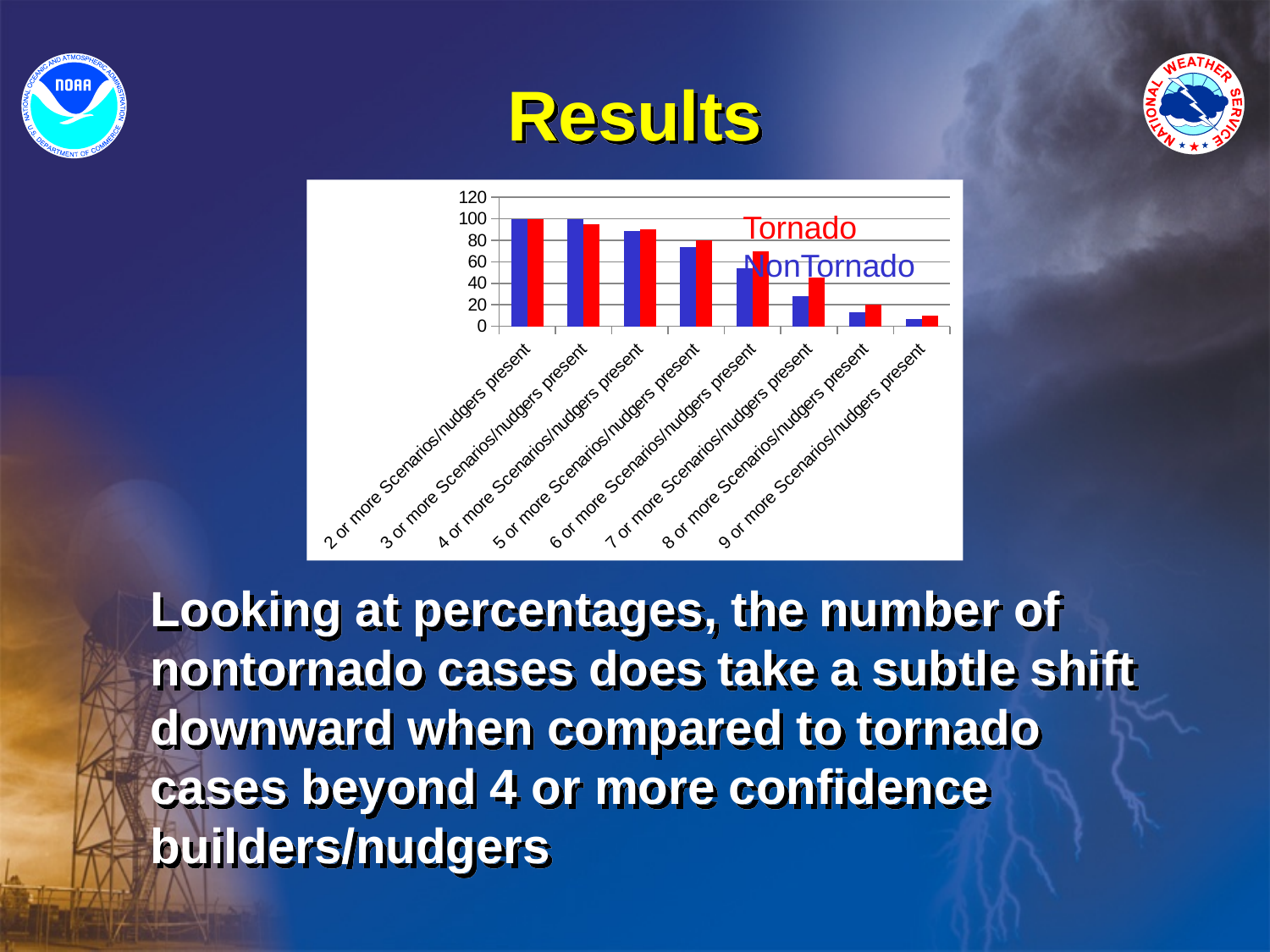
For '7 or more Scenarios/nudgers present', which series has the larger value, Tornado or NonTornado? Tornado Which colour represents the Tornado series in the chart? red Is the NonTornado value for '7 or more Scenarios/nudgers present' greater or less than 40? less Is the Tornado value for '5 or more Scenarios/nudgers present' greater or less than 60? greater Which colour represents the NonTornado series in the chart? blue What kind of chart is shown on the slide? bar chart How many series does the chart's legend list? 2 Is the Tornado value for '7 or more Scenarios/nudgers present' greater or less than 40? greater Do the values for the NonTornado series rise or fall as you move from '2 or more' to '9 or more Scenarios/nudgers present'? fall Which category has the lowest NonTornado value? 9 or more Scenarios/nudgers present How many categories are shown along the x axis of the chart? 8